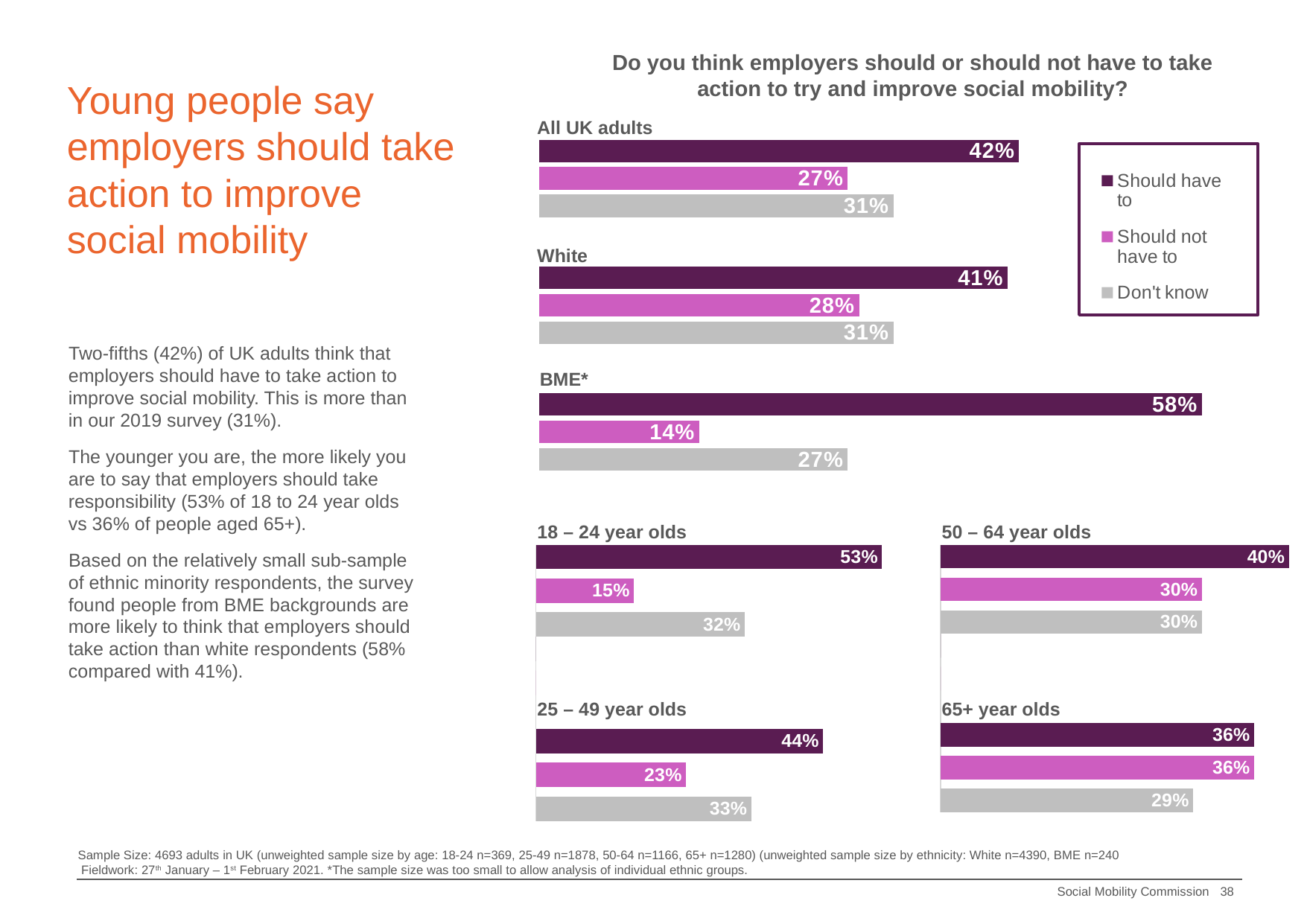
In the '50 – 64 year olds' chart, what is the 'Should not have to' value? 30% What is the difference between the 'Should have to' values in the 'BME*' chart and the 'White' chart? 17% What type of chart is used to show the survey responses? Bar chart Which colour represents 'Don't know' in the legend? Grey In the 'BME*' chart, what percentage say employers should not have to take action? 14% In the '25 – 49 year olds' chart, which response has the lowest value? Should not have to How many series does the legend list? 3 What is the difference between the 'Should have to' and 'Should not have to' values in the 'All UK adults' chart? 15% Which is larger: the 'Should have to' value for '18 – 24 year olds' or for '65+ year olds'? 18 – 24 year olds In the '65+ year olds' chart, what is the 'Don't know' value? 29% In the '18 – 24 year olds' chart, which response has the highest value? Should have to In the 'All UK adults' chart, what percentage say employers should have to take action? 42%